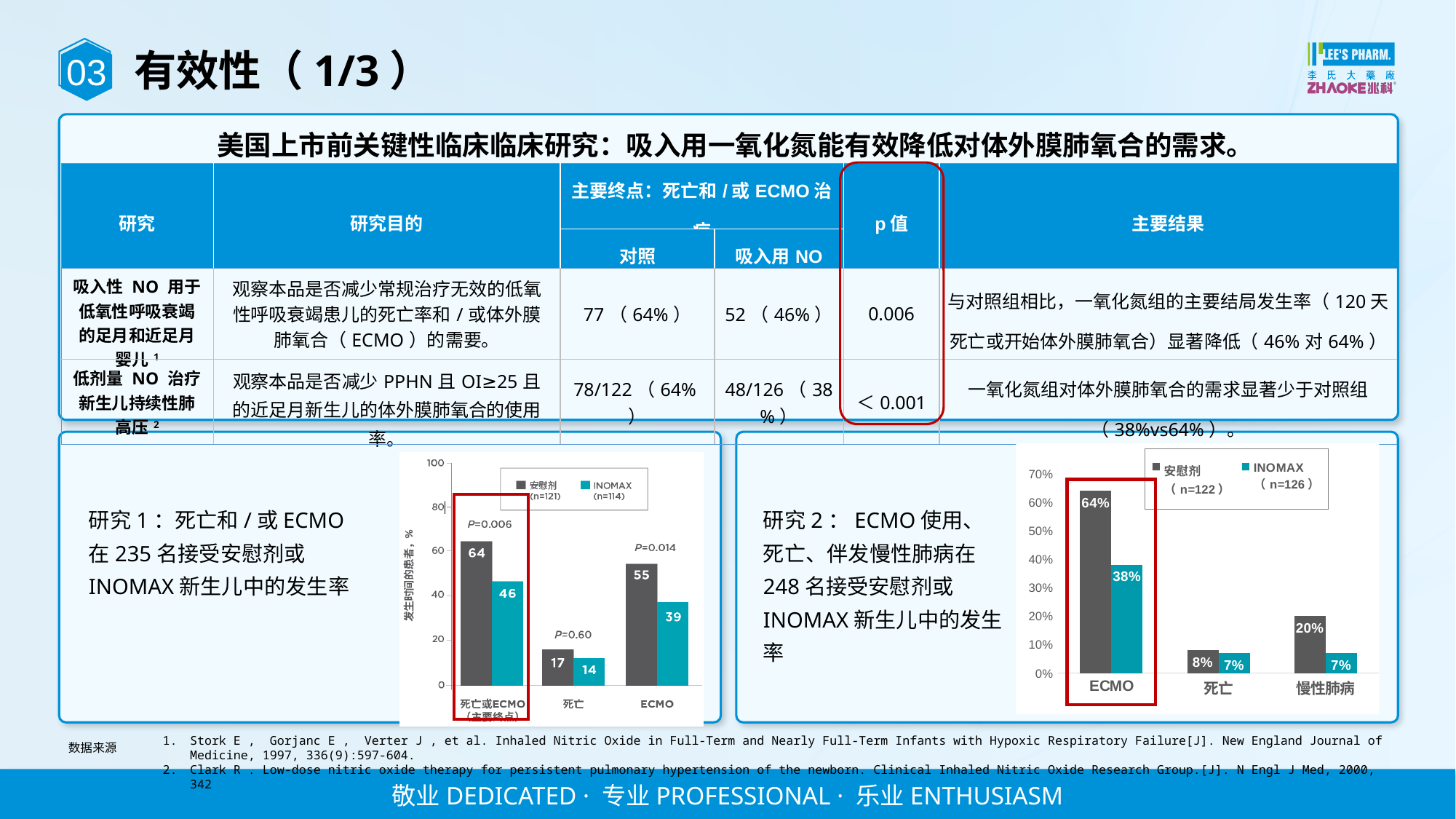
In the left chart (研究1), what is the value for 安慰剂 in the 死亡或ECMO category? 64 In the right chart (研究2), what is the value for 安慰剂 in the 慢性肺病 category? 20% What type of chart is the right chart (研究2)? Bar chart In the right chart (研究2), how many categories are shown on the x axis? 3 In the left chart (研究1), what is the value for INOMAX in the ECMO category? 39 In the right chart (研究2), what is the value for INOMAX in the ECMO category? 38% In the right chart (研究2), which category has the highest 安慰剂 value? ECMO In the left chart (研究1), what P value is shown above the ECMO category? P=0.014 In the left chart (研究1), what is the difference between the 安慰剂 and INOMAX values for 死亡? 3 In the left chart (研究1), which category has the lowest INOMAX value? 死亡 In the right chart (研究2), what is the difference between the 安慰剂 and INOMAX values for ECMO? 26% In the left chart (研究1), how many series does the legend list? 2